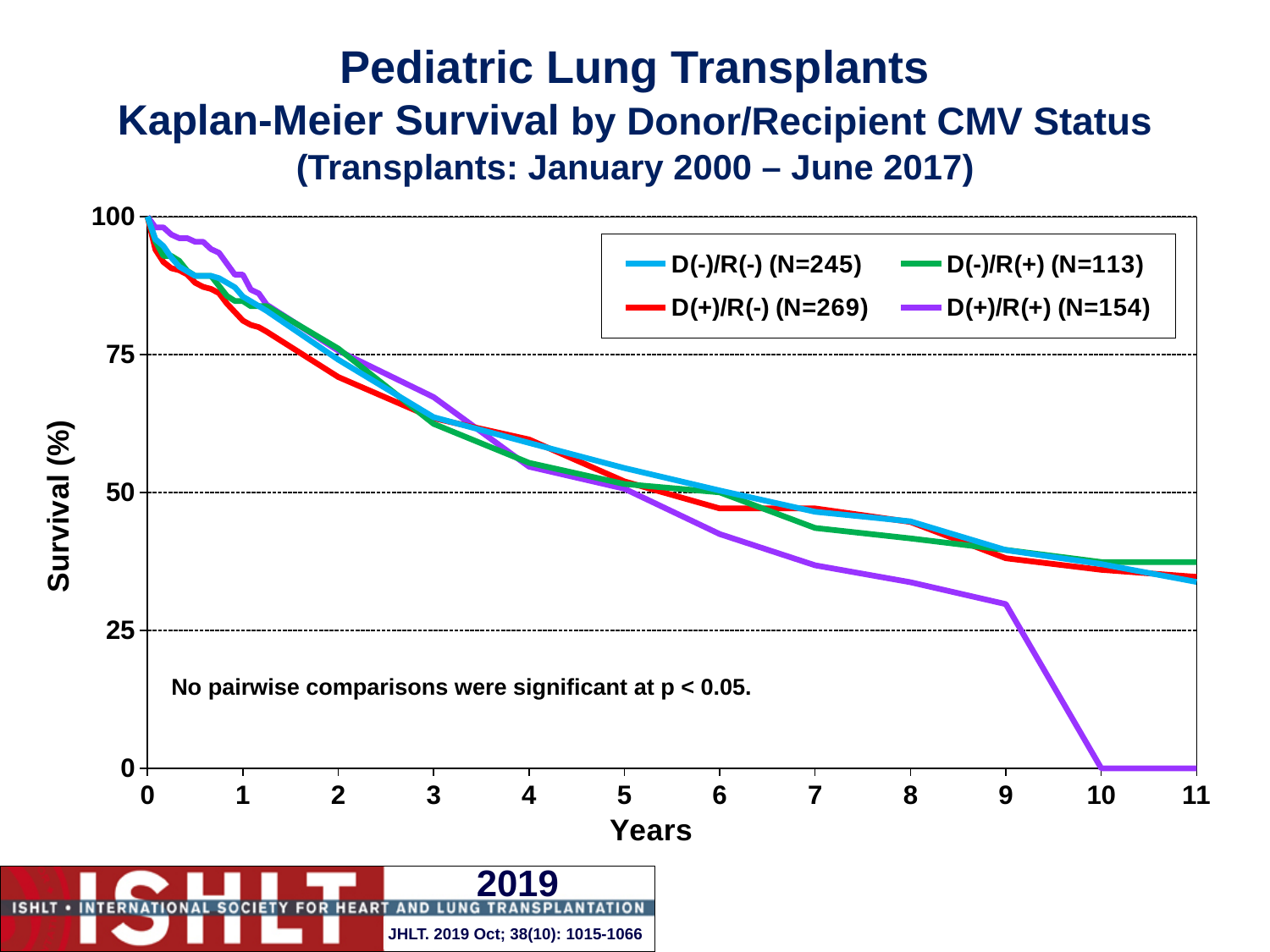
What is the N for the D(+)/R(-) group shown in the legend? 269 What kind of chart is shown on the slide? Line chart What is the survival (%) for D(+)/R(+) at year 11? 0 How many series does the legend list? 4 Do the survival curves rise or fall as years increase? fall Is the survival for D(-)/R(-) at year 11 greater or less than 25? greater At year 9, which group has higher survival: D(-)/R(-) or D(+)/R(+)? D(-)/R(-) What is the survival (%) for all groups at year 0? 100 Is the survival for D(+)/R(-) at year 2 greater or less than 50? greater Is the survival for D(+)/R(+) at year 9 greater or less than 50? less Which group has the lowest survival at year 11? D(+)/R(+) (N=154) Which group has the lowest survival at year 9? D(+)/R(+) (N=154)